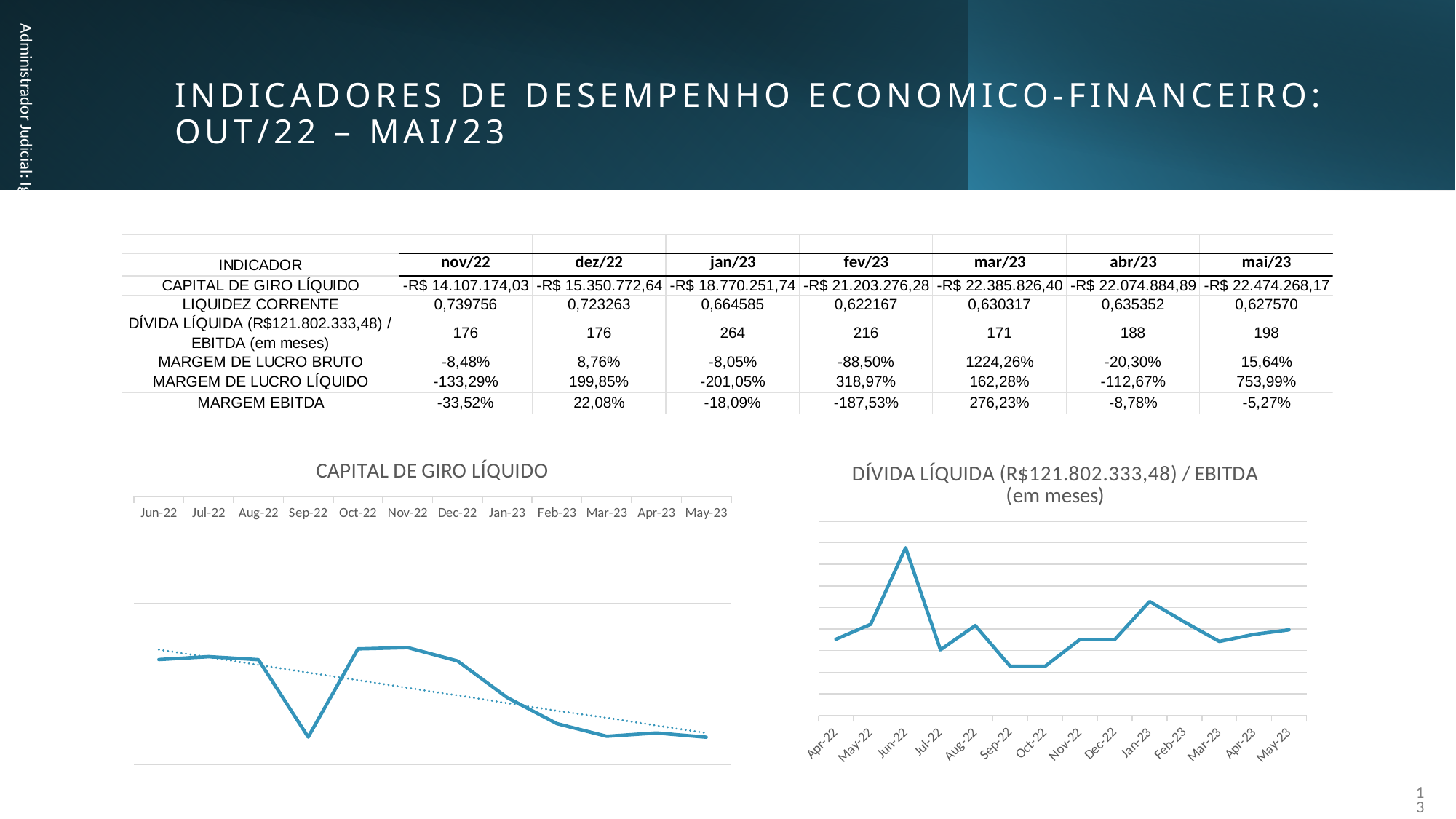
In the DÍVIDA LÍQUIDA / EBITDA chart, is the value for Jun-22 or Jan-23 higher? Jun-22 In the DÍVIDA LÍQUIDA / EBITDA chart, which month has the highest value? Jun-22 In the CAPITAL DE GIRO LÍQUIDO chart, is the value for Nov-22 or Sep-22 higher? Nov-22 In the DÍVIDA LÍQUIDA / EBITDA chart, does the line rise or fall from Jun-22 to Jul-22? Fall What is the first month on the x axis of the DÍVIDA LÍQUIDA / EBITDA chart? Apr-22 How many months are shown on the x axis of the CAPITAL DE GIRO LÍQUIDO chart? 12 What kind of chart is the DÍVIDA LÍQUIDA (R$121.802.333,48) / EBITDA (em meses) chart? Line chart In the CAPITAL DE GIRO LÍQUIDO chart, does the line rise or fall from Nov-22 to Mar-23? Fall What kind of chart is the CAPITAL DE GIRO LÍQUIDO chart? Line chart How many months are shown on the x axis of the DÍVIDA LÍQUIDA / EBITDA chart? 14 Besides the solid data line, what other line is drawn on the CAPITAL DE GIRO LÍQUIDO chart? A dotted trend line In the DÍVIDA LÍQUIDA / EBITDA chart, is the value for Aug-22 or Jul-22 higher? Aug-22